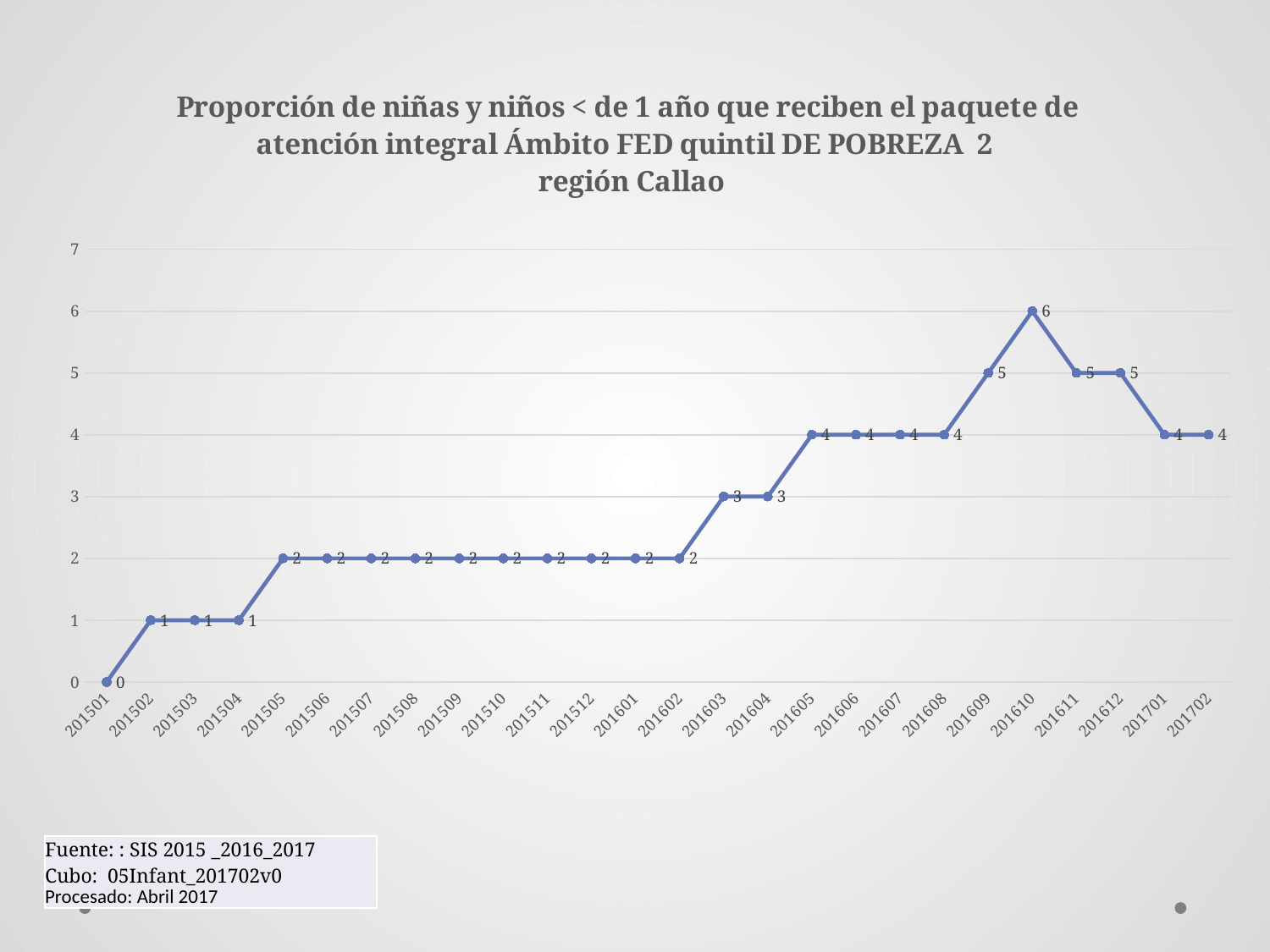
What is the value for 201702? 4 Do the values generally rise or fall from 201501 to 201610? Rise What is the value for 201501? 0 Which period has the lowest value? 201501 What is the value for 201603? 3 What kind of chart is shown on the slide? Line chart What region is named in the chart title? Callao Which period has the highest value? 201610 What is the value for 201610? 6 Which is larger, the value for 201609 or the value for 201605? 201609 How many data points are plotted on the chart? 26 What is the difference between the values for 201610 and 201701? 2